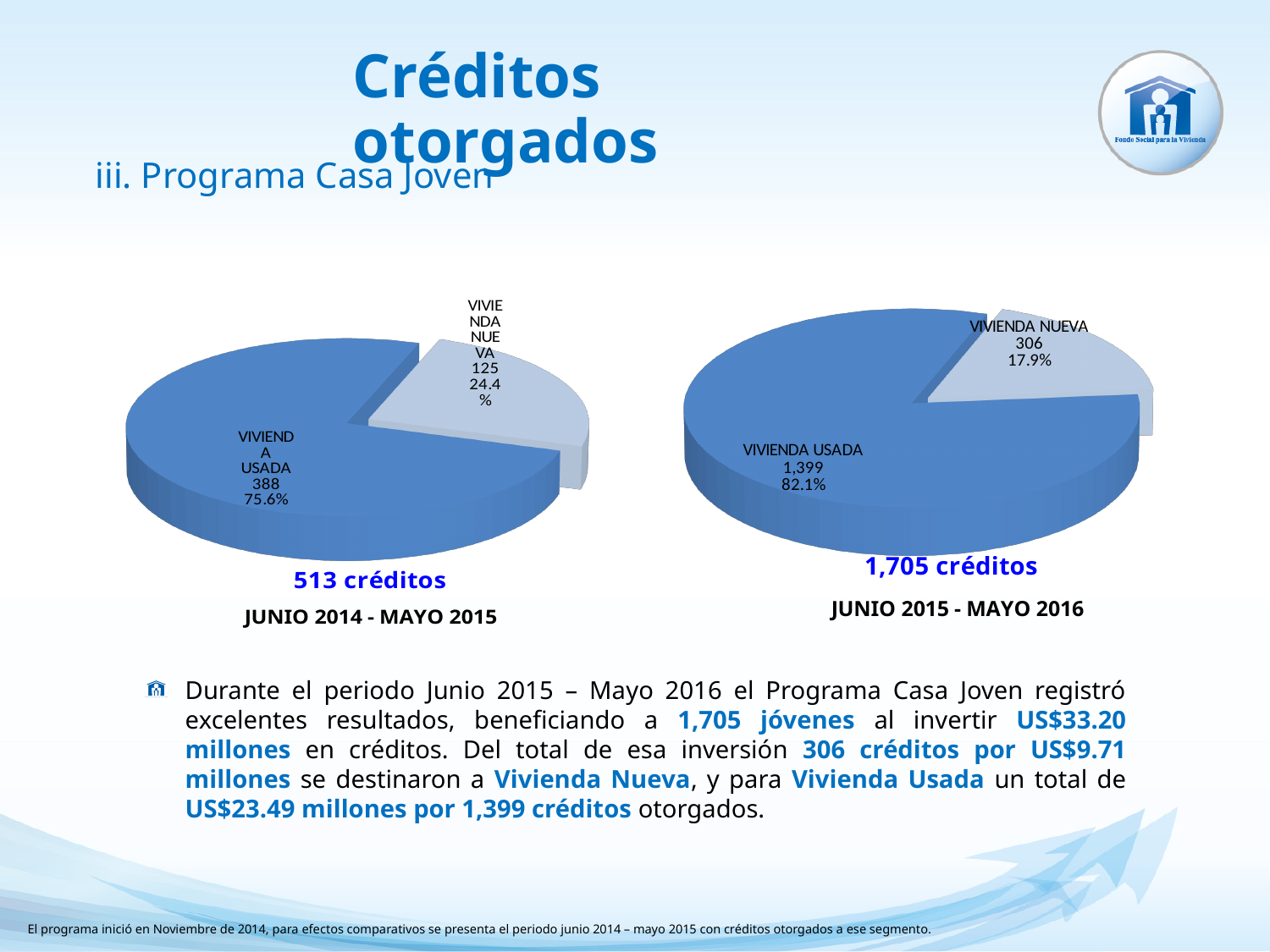
In the JUNIO 2015 - MAYO 2016 chart, how many credits were for VIVIENDA NUEVA? 306 In the JUNIO 2015 - MAYO 2016 chart, what share of the pie is VIVIENDA USADA? 82.1% In the JUNIO 2014 - MAYO 2015 chart, which category has the smallest slice? VIVIENDA NUEVA In the JUNIO 2015 - MAYO 2016 chart, what is the difference in credits between VIVIENDA USADA and VIVIENDA NUEVA? 1,093 In the JUNIO 2014 - MAYO 2015 chart, how many credits were for VIVIENDA USADA? 388 Which is larger: VIVIENDA NUEVA credits in the JUNIO 2014 - MAYO 2015 chart or VIVIENDA NUEVA credits in the JUNIO 2015 - MAYO 2016 chart? JUNIO 2015 - MAYO 2016 What total number of credits is shown below the JUNIO 2014 - MAYO 2015 chart? 513 créditos In the JUNIO 2014 - MAYO 2015 chart, what share of the pie is VIVIENDA NUEVA? 24.4% In the JUNIO 2015 - MAYO 2016 chart, which category has the largest slice? VIVIENDA USADA What type of chart is used for the JUNIO 2015 - MAYO 2016 data? Pie chart In the JUNIO 2014 - MAYO 2015 chart, what is the difference in credits between VIVIENDA USADA and VIVIENDA NUEVA? 263 How many categories does each pie chart on the slide show? 2